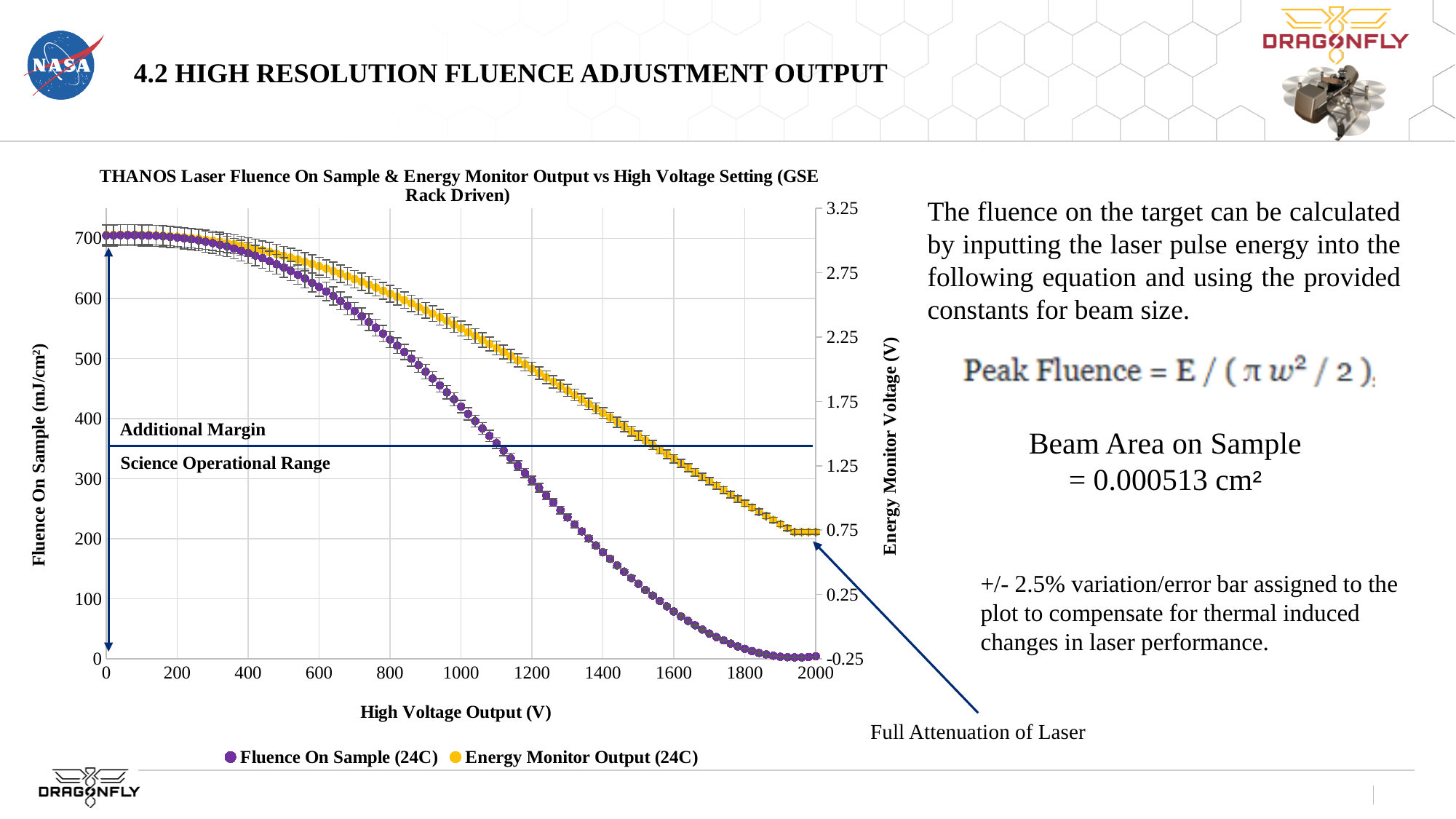
Is the Fluence On Sample value at 0 V greater or less than 600 mJ/cm²? greater Does the Energy Monitor Output (24C) series rise or fall as High Voltage Output increases? fall What are the two series listed in the chart legend? Fluence On Sample (24C) and Energy Monitor Output (24C) What is the label of the chart's x axis? High Voltage Output (V) How many series does the chart legend list? 2 What kind of chart is shown on the slide? scatter chart Is the Fluence On Sample value at 2000 V greater or less than 100 mJ/cm²? less Does the Fluence On Sample (24C) series rise or fall as High Voltage Output increases? fall Is the Fluence On Sample value at 1000 V greater or less than 300 mJ/cm²? greater